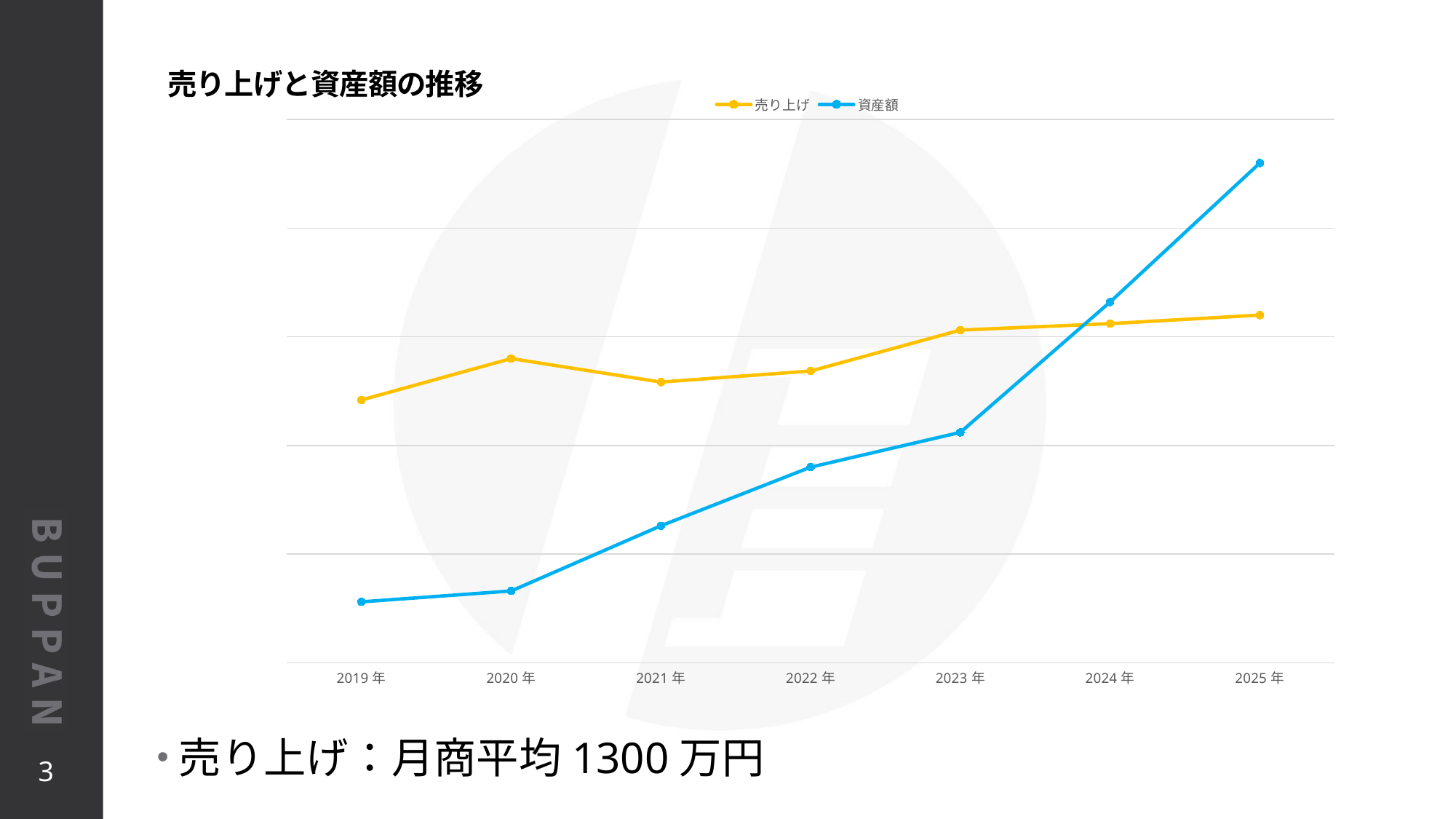
In which year is 資産額 lowest? 2019 年 How many series does the legend list? 2 What kind of chart is shown on the slide? line chart In 2025 年, which series has the higher value, 売り上げ or 資産額? 資産額 Does 資産額 rise or fall from 2019 年 to 2025 年? rise What is the title of the chart? 売り上げと資産額の推移 In which year is 売り上げ lowest? 2019 年 Which series is drawn in blue? 資産額 In which year is 売り上げ highest? 2025 年 How many years are plotted along the x axis? 7 In 2019 年, which series has the higher value, 売り上げ or 資産額? 売り上げ In which year is 資産額 highest? 2025 年